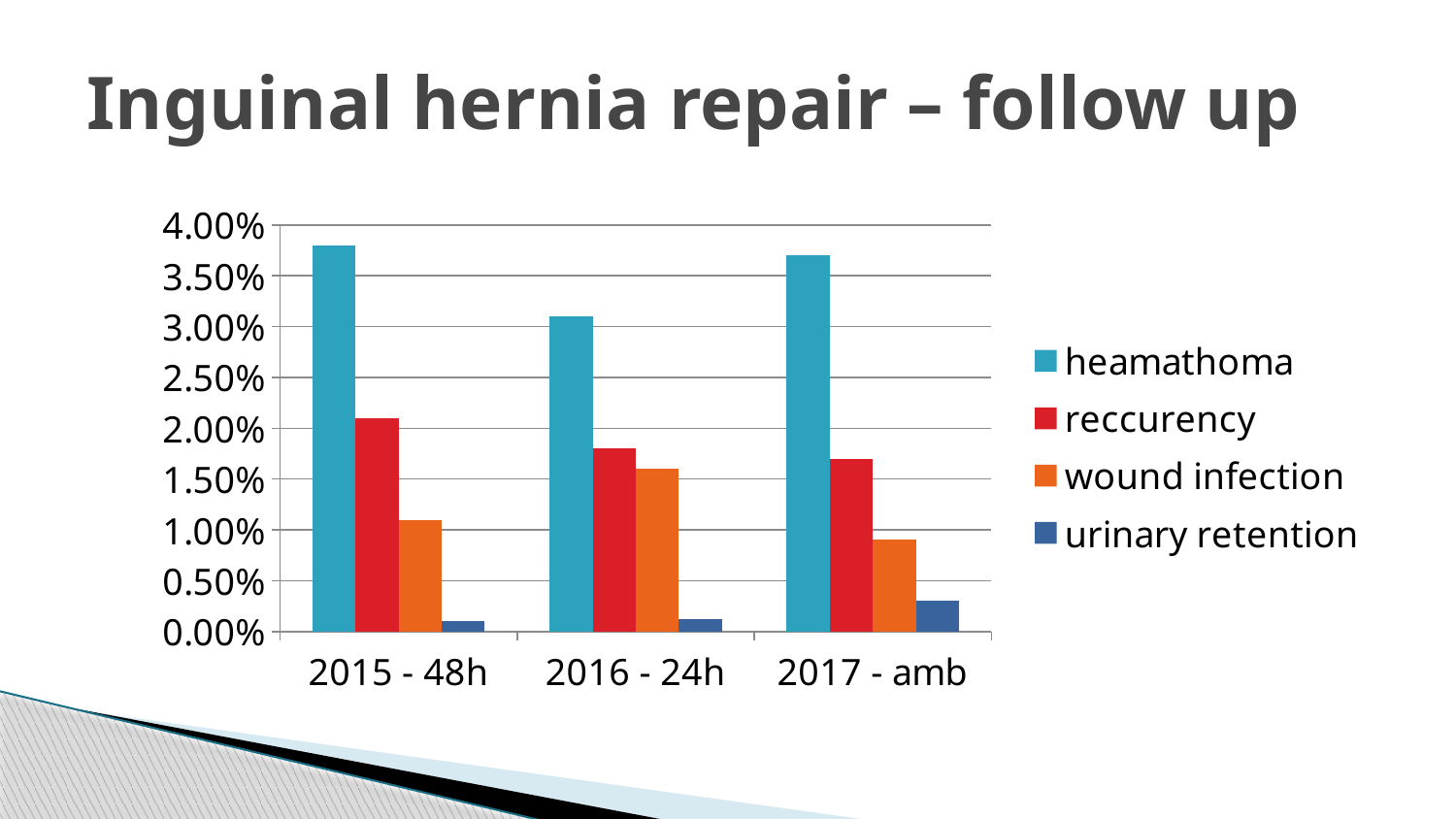
How many categories are shown on the x axis? 3 Which series has the lowest value in 2017 - amb? urinary retention Is the value for reccurency in 2015 - 48h greater or less than 1.50%? greater Is the value for wound infection in 2016 - 24h greater or less than 1.00%? greater Is the value for urinary retention in 2017 - amb greater or less than 0.50%? less Which series has the highest value in 2016 - 24h? heamathoma What kind of chart is shown on the slide? bar chart Which is larger, the wound infection value for 2016 - 24h or for 2017 - amb? 2016 - 24h How many series does the legend list? 4 Which is larger, the heamathoma value for 2015 - 48h or for 2016 - 24h? 2015 - 48h